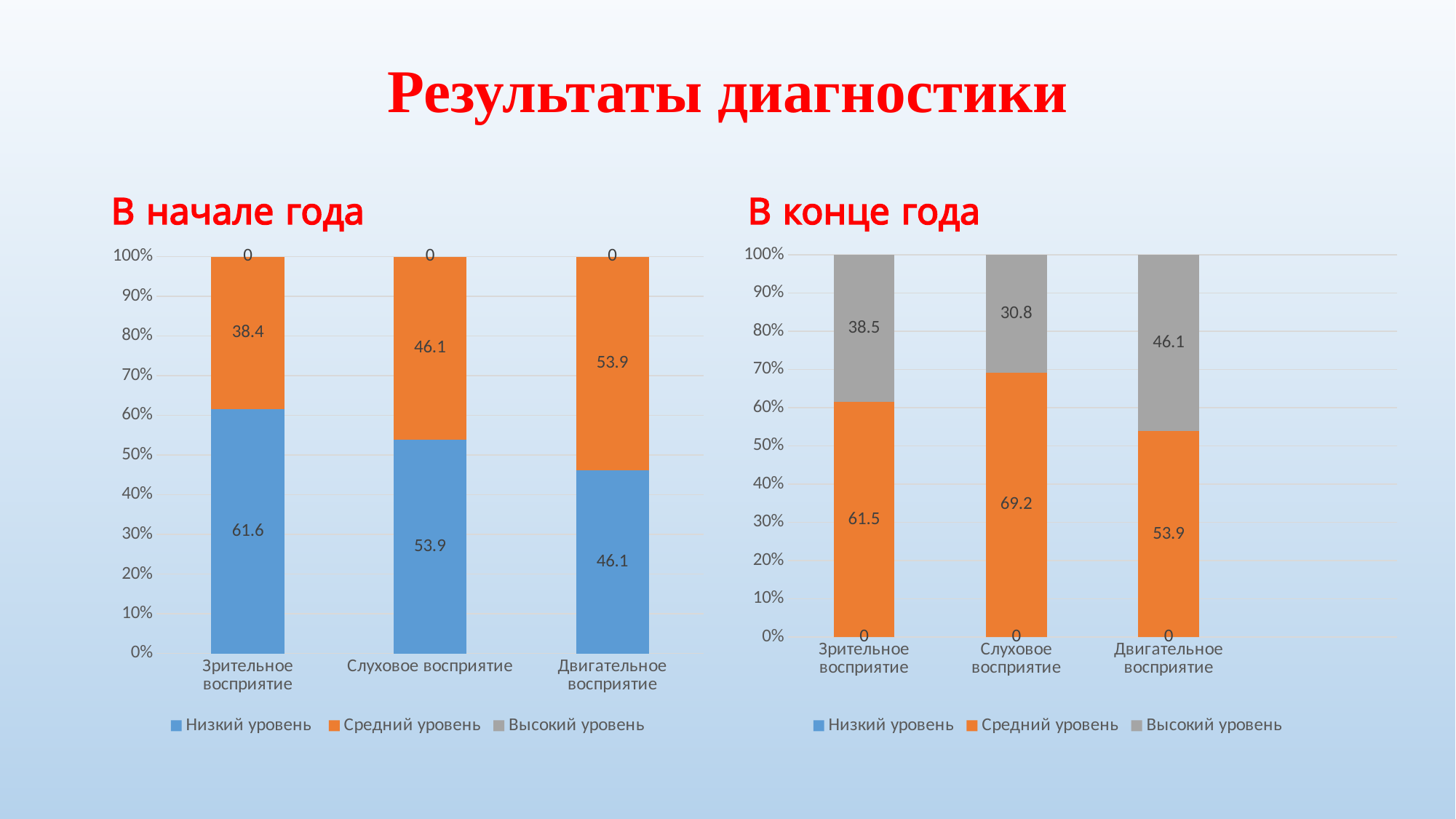
How many categories are shown on the x axis of the chart "В конце года"? 3 In the chart "В конце года", what is the value of "Высокий уровень" for "Слуховое восприятие"? 30.8 In the chart "В конце года", which category has the lowest value for "Высокий уровень"? Слуховое восприятие In the chart "В начале года", what is the value of "Высокий уровень" for "Слуховое восприятие"? 0 In the chart "В начале года", what is the value of "Низкий уровень" for "Зрительное восприятие"? 61.6 In the chart "В начале года", which category has the highest value for "Средний уровень"? Двигательное восприятие In the chart "В конце года", what is the value of "Средний уровень" for "Двигательное восприятие"? 53.9 In the chart "В конце года", which is larger: "Средний уровень" for "Слуховое восприятие" or for "Зрительное восприятие"? Слуховое восприятие What type of chart is "В конце года"? Stacked bar chart In the chart "В начале года", what is the difference between the "Низкий уровень" values for "Зрительное восприятие" and "Двигательное восприятие"? 15.5 How many series does the legend of the chart "В начале года" list? 3 In the chart "В конце года", what colour represents "Высокий уровень"? Grey